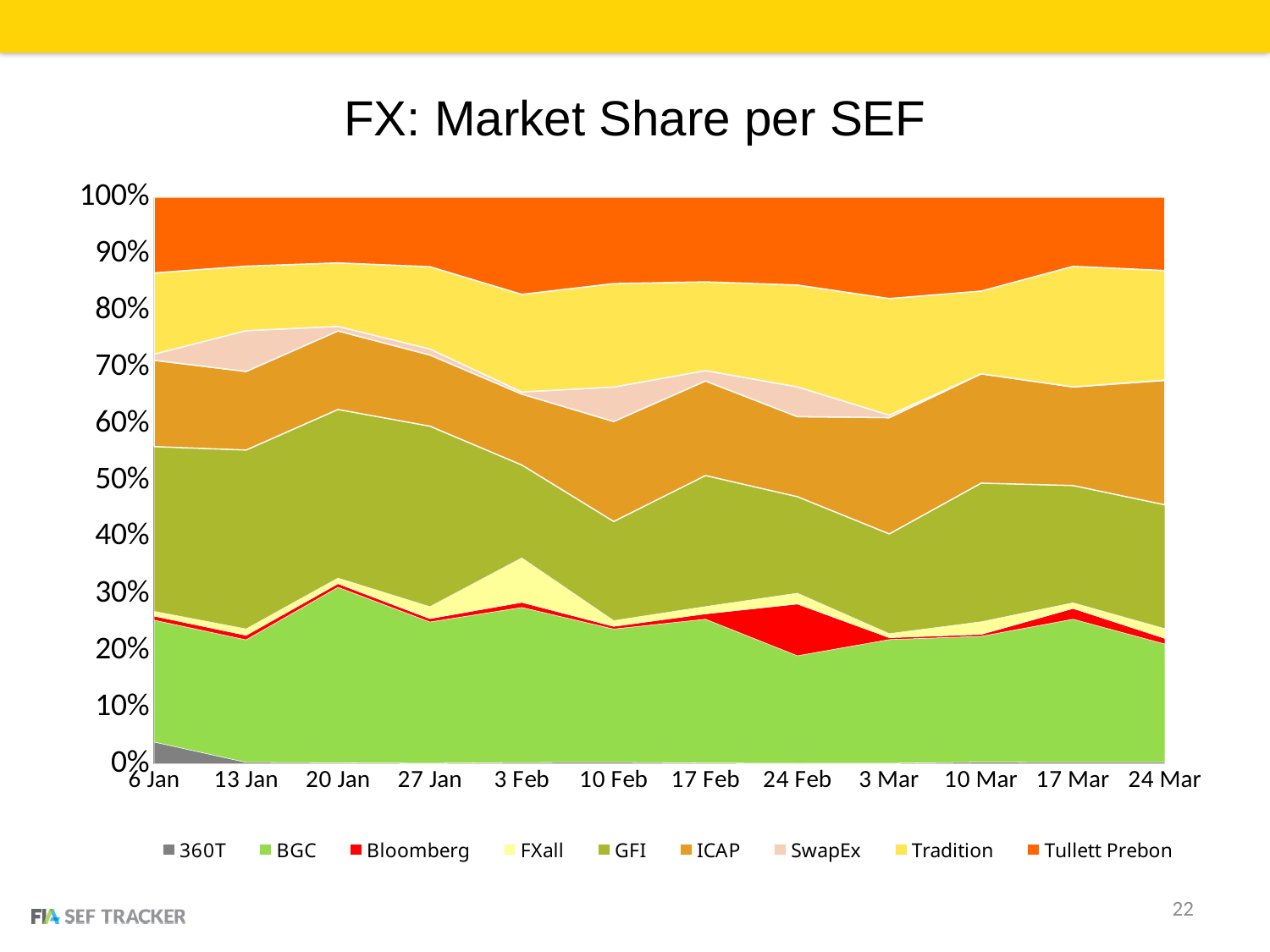
What kind of chart is shown on the slide? Stacked area chart Is the value for Bloomberg on 24 Feb greater or less than 5%? greater Which is larger, Bloomberg's share on 24 Feb or on 10 Mar? 24 Feb On which date is Bloomberg's share the highest? 24 Feb On which date is 360T's share the highest? 6 Jan Which series is at the bottom of the stack? 360T How many series does the legend list? 9 Is the value for Tullett Prebon on 3 Feb greater or less than 10%? greater What is the title of the chart? FX: Market Share per SEF How many dates are shown along the x axis? 12 Does BGC's share rise or fall from 13 Jan to 20 Jan? rise Is the value for BGC on 20 Jan greater or less than 20%? greater